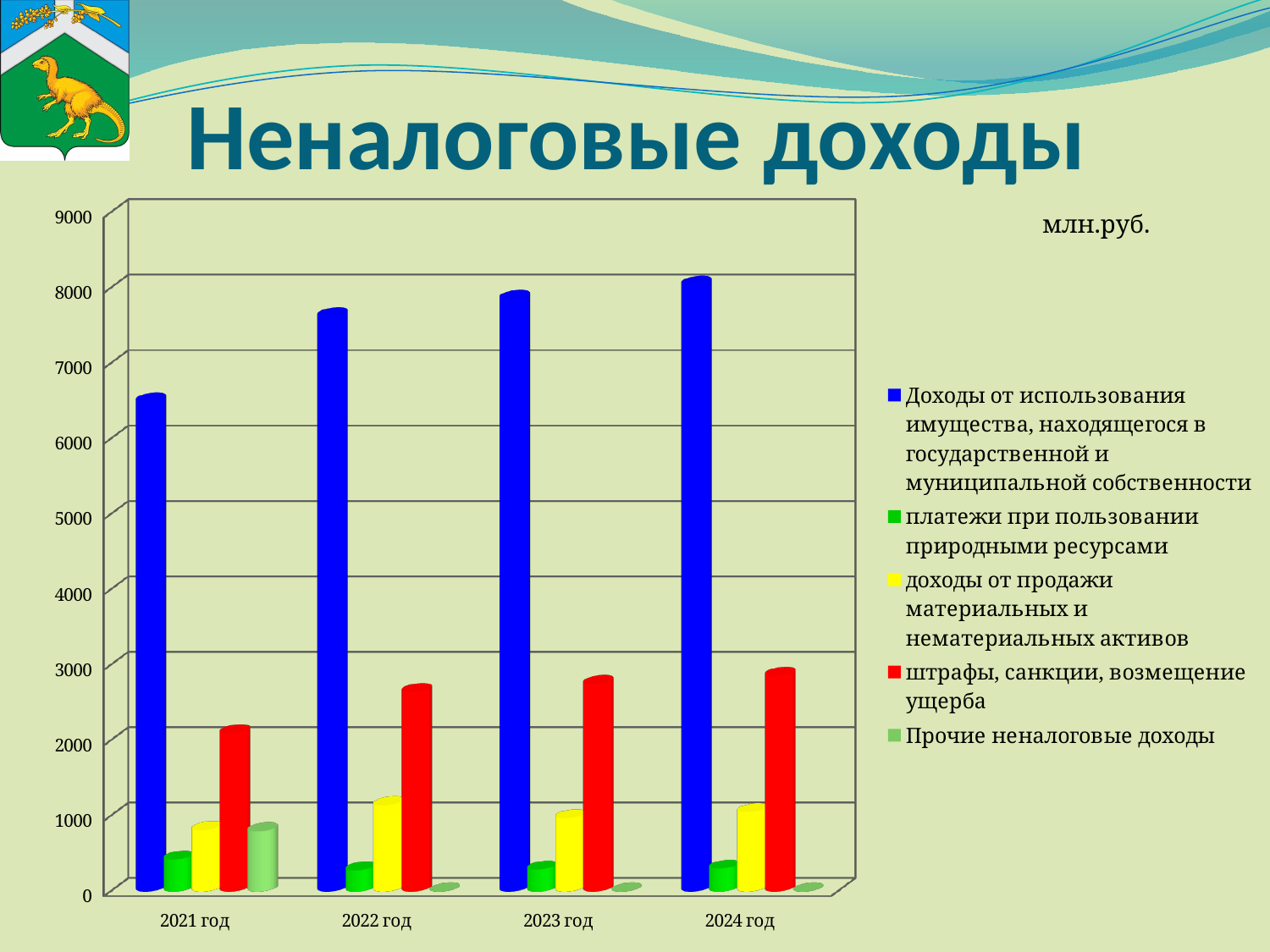
How many series does the legend list? 5 Is the value for 'штрафы, санкции, возмещение ущерба' in 2021 год greater or less than 3000? less Do the values for 'Доходы от использования имущества, находящегося в государственной и муниципальной собственности' rise or fall from 2021 год to 2024 год? rise In what units are the values on the chart given? млн.руб. In which year is the value for 'штрафы, санкции, возмещение ущерба' the lowest? 2021 год How many year categories are shown on the x axis? 4 In which year is the value for 'Доходы от использования имущества, находящегося в государственной и муниципальной собственности' the highest? 2024 год What is the title of the slide chart? Неналоговые доходы In which year is the value for 'Доходы от использования имущества, находящегося в государственной и муниципальной собственности' the lowest? 2021 год What kind of chart is shown on the slide? bar chart Which is larger in 2022 год: 'штрафы, санкции, возмещение ущерба' or 'доходы от продажи материальных и нематериальных активов'? штрафы, санкции, возмещение ущерба